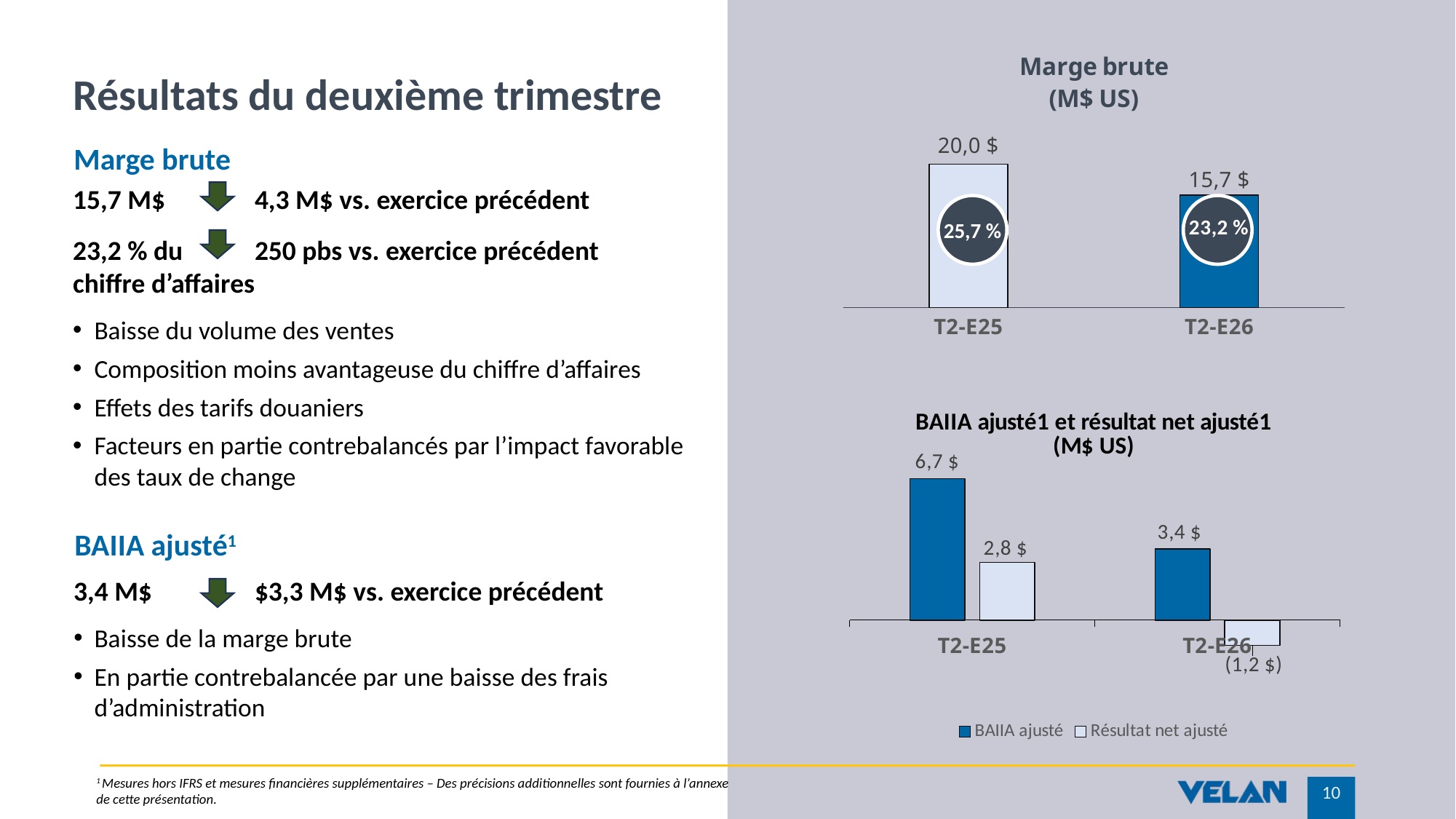
In the 'Marge brute' chart, what is the value for T2-E26? 15,7 $ In the 'BAIIA ajusté et résultat net ajusté' chart, what is the Résultat net ajusté value for T2-E25? 2,8 $ In the 'Marge brute' chart, which period has the higher gross margin? T2-E25 What type of chart is the 'BAIIA ajusté et résultat net ajusté' chart? bar chart In the 'Marge brute' chart, do the values rise or fall from T2-E25 to T2-E26? fall In the 'BAIIA ajusté et résultat net ajusté' chart, what is the BAIIA ajusté value for T2-E25? 6,7 $ In the 'BAIIA ajusté et résultat net ajusté' chart, what is the Résultat net ajusté value for T2-E26? (1,2 $) In the 'BAIIA ajusté et résultat net ajusté' chart, how many series does the legend list? 2 In the 'Marge brute' chart, what is the difference between the T2-E25 and T2-E26 values? 4,3 $ In the 'Marge brute' chart, what is the value for T2-E25? 20,0 $ In the 'Marge brute' chart, what percentage is shown inside the T2-E26 bar? 23,2 % In the 'BAIIA ajusté et résultat net ajusté' chart, what is the difference in BAIIA ajusté between T2-E25 and T2-E26? 3,3 $